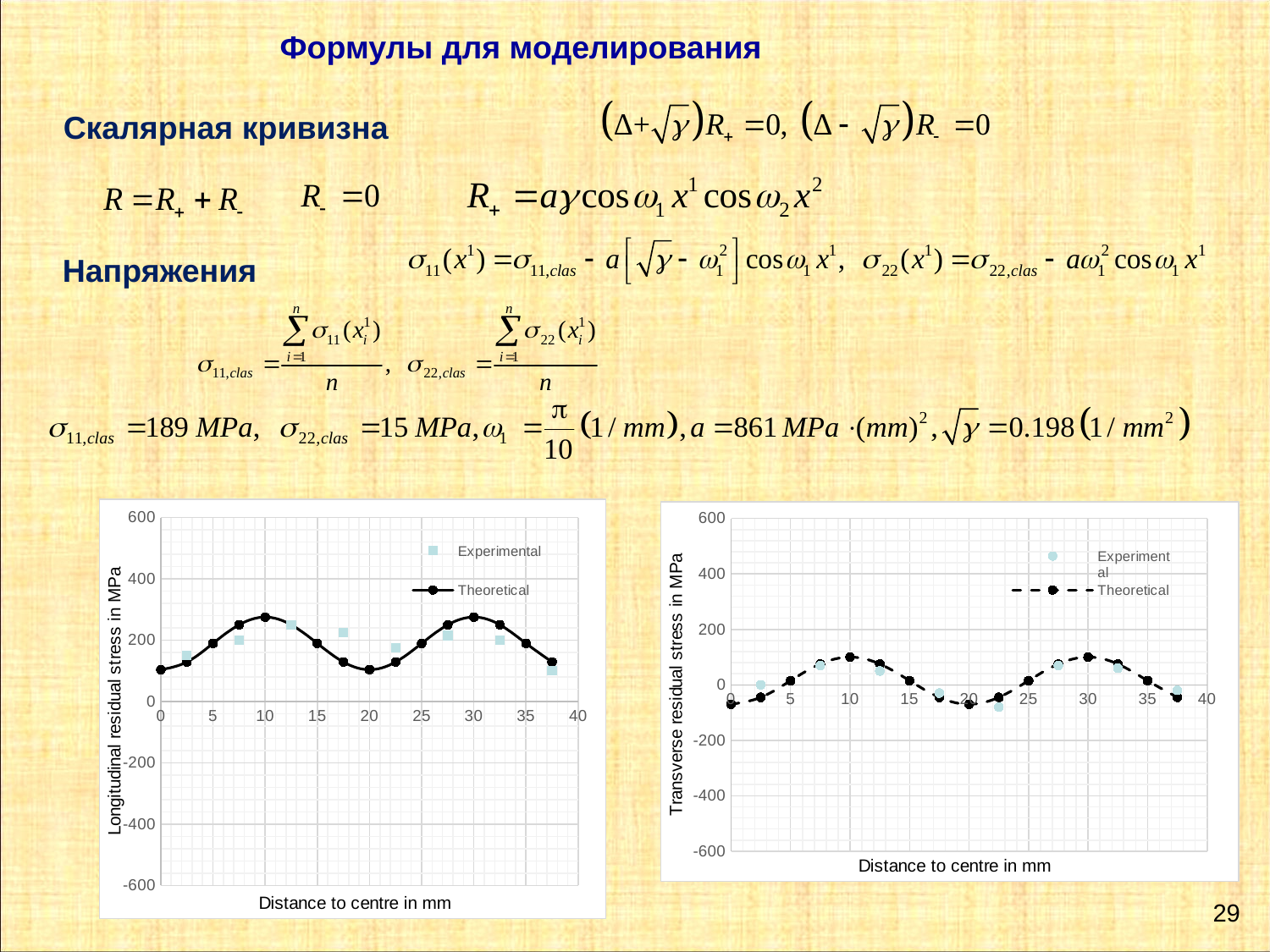
In the left chart, which is larger: the Theoretical value at 10 mm or at 20 mm? 10 mm In the right chart, is the Theoretical value at 20 mm greater or less than 0? less In the right chart, is the Theoretical value at 10 mm greater or less than 0? greater In the left chart, is the Theoretical value at 10 mm greater or less than 200? greater How many series does the legend of the right chart list? 2 What kind of chart is the left chart (Longitudinal residual stress)? line chart with scatter points In the right chart, does the Theoretical curve rise or fall between 0 mm and 10 mm? rise What is the x-axis title of the left chart? Distance to centre in mm How many Experimental points are plotted in the left chart? 8 What is the y-axis title of the right chart? Transverse residual stress in MPa How many series does the legend of the left chart list? 2